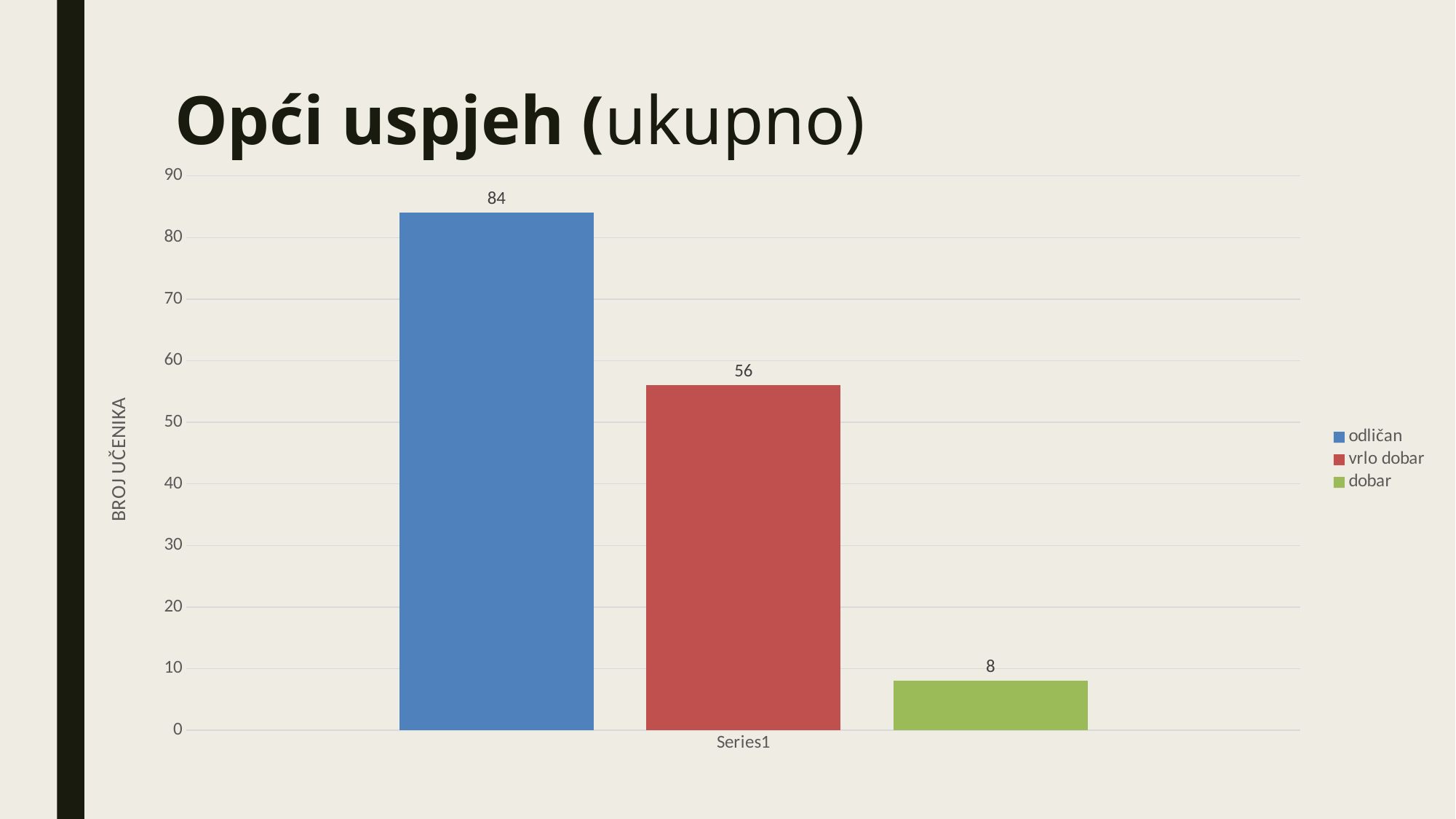
Is the value for odličan greater or less than 80? greater What is the difference between the values for odličan and vrlo dobar? 28 What is the difference between the values for vrlo dobar and dobar? 48 Which series has the lowest value? dobar What is the value for dobar? 8 Which is larger, the value for vrlo dobar or the value for dobar? vrlo dobar Which series has the highest value? odličan How many series does the legend list? 3 What is the label on the vertical axis? BROJ UČENIKA What is the value for odličan? 84 What kind of chart is shown on the slide? bar chart What is the value for vrlo dobar? 56